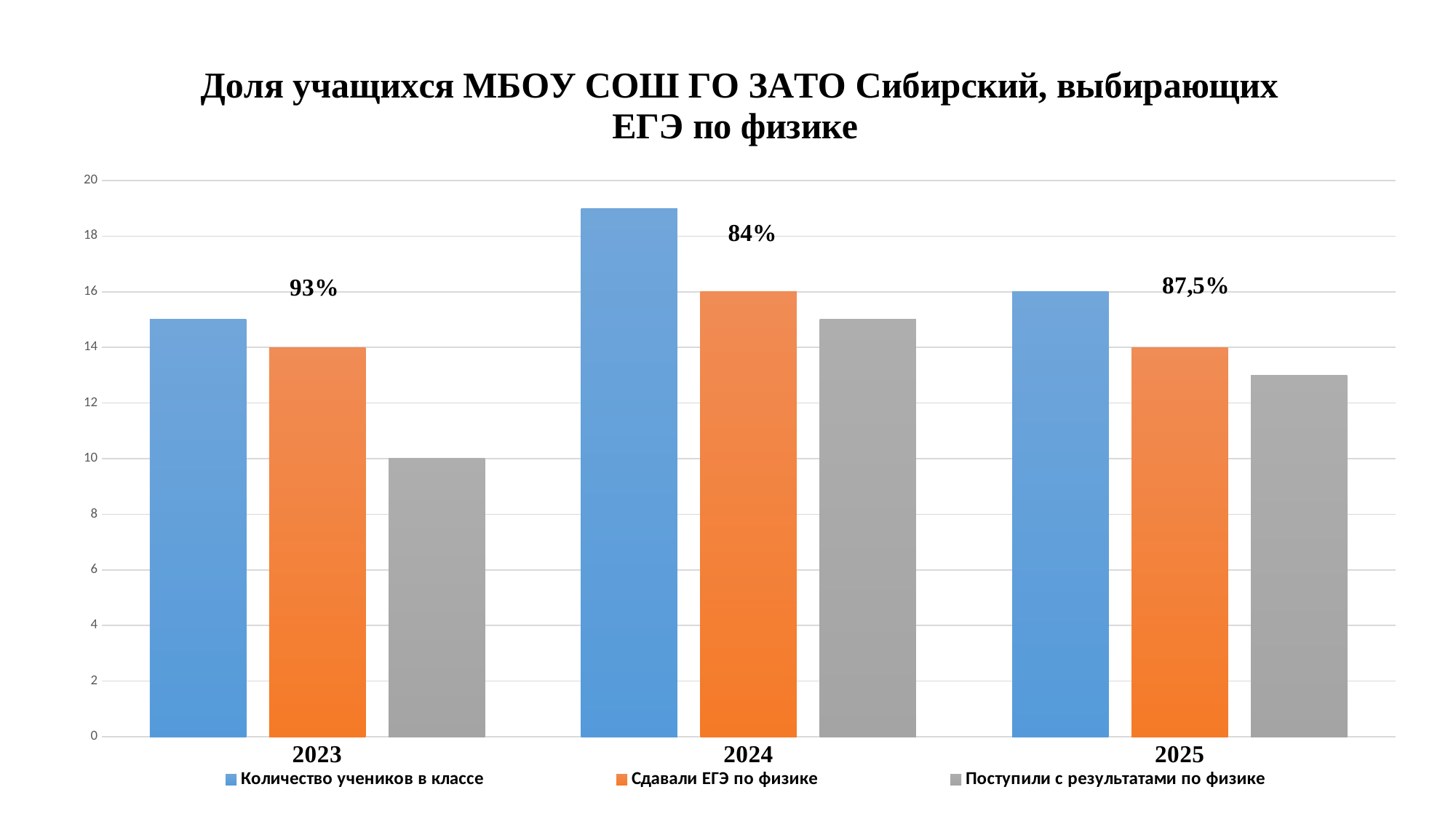
What kind of chart is shown on the slide? bar chart What is the value for 'Сдавали ЕГЭ по физике' in 2023? 14 Is the value for 'Количество учеников в классе' in 2024 greater or less than 18? greater What is the value for 'Поступили с результатами по физике' in 2023? 10 How many years are shown on the x axis? 3 In which year is 'Количество учеников в классе' the highest? 2024 What percentage label is printed above the 2024 group of bars? 84% What is the difference between 'Сдавали ЕГЭ по физике' in 2024 and in 2023? 2 What is the value for 'Сдавали ЕГЭ по физике' in 2024? 16 In which year is 'Поступили с результатами по физике' the lowest? 2023 What is the value for 'Количество учеников в классе' in 2025? 16 How many series does the legend list? 3